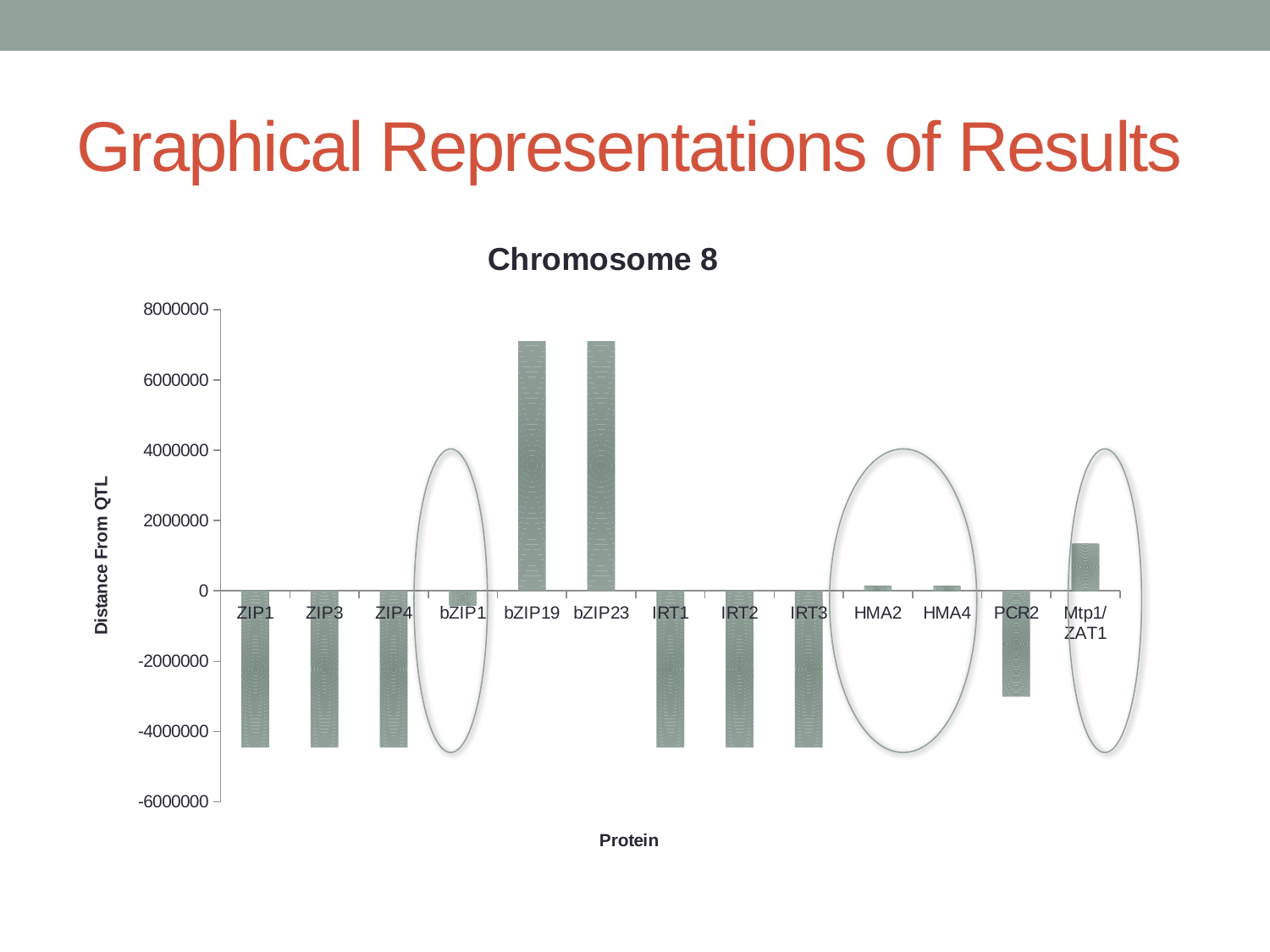
Which has the larger value, Mtp1/ZAT1 or HMA2? Mtp1/ZAT1 Is the value for Mtp1/ZAT1 greater or less than 2000000? less Is the value for IRT2 greater or less than 0? less What is the label on the y axis of the chart? Distance From QTL Which has the larger value, bZIP23 or PCR2? bZIP23 How many proteins are plotted along the x axis of the Chromosome 8 chart? 13 What is the title of the chart? Chromosome 8 Is the value for bZIP19 greater or less than 6000000? greater Which has the larger value, bZIP1 or ZIP4? bZIP1 What kind of chart is shown on the slide? bar chart